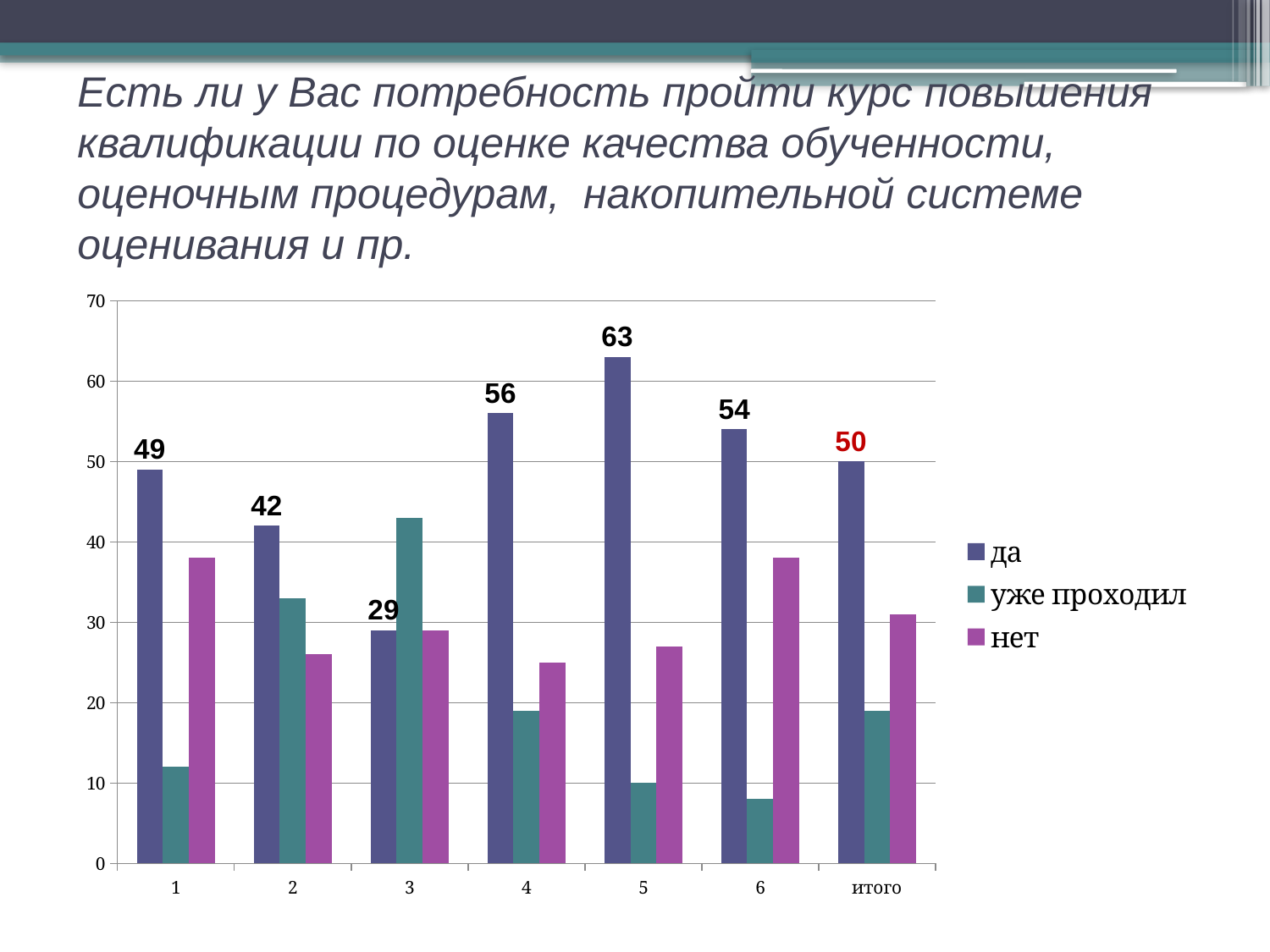
Which is larger: the "да" value for category 4 or for category 6? category 4 Which category has the lowest value in the "да" series? 3 What is the value of the "да" series for category 3? 29 How many series does the legend list? 3 Is the value of "уже проходил" for category 3 greater or less than 40? greater What is the value of the "да" series for "итого"? 50 What is the value of the "да" series for category 5? 63 How many categories are shown on the x axis? 7 Is the value of "нет" for category 6 greater or less than 30? greater What is the difference between the "да" values for category 5 and category 1? 14 Which category has the highest value in the "да" series? 5 What type of chart is shown on the slide? bar chart